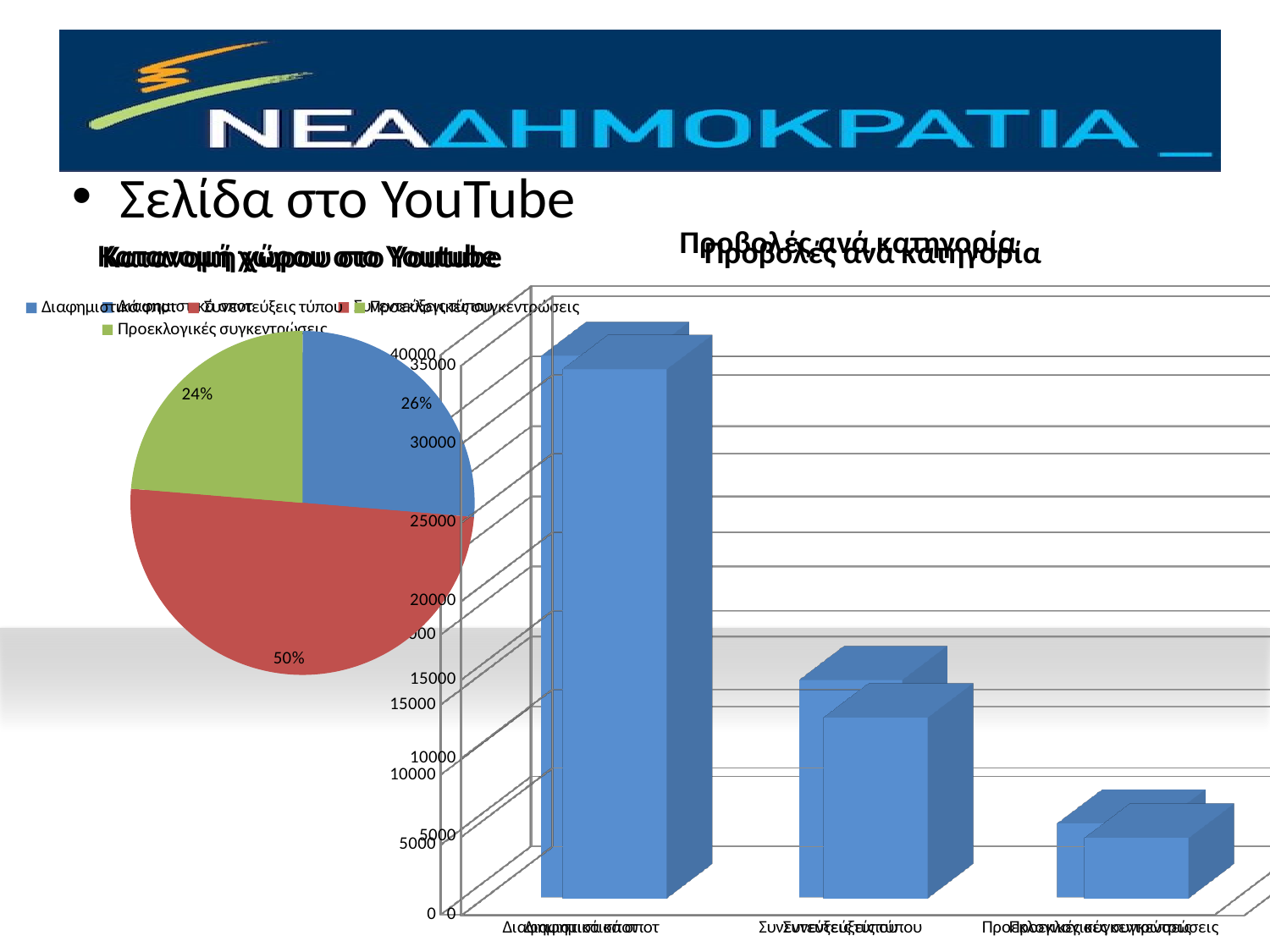
What kind of chart is the chart on the right titled 'Προβολές ανά κατηγορία'? Bar chart How many slices does the pie chart 'Κατανομή χώρου στο Youtube' have? 3 In the pie chart 'Κατανομή χώρου στο Youtube', which category has the smallest share? Προεκλογικές συγκεντρώσεις In the bar chart 'Προβολές ανά κατηγορία', do the values rise or fall from left to right across the categories? Fall In the bar chart 'Προβολές ανά κατηγορία', which category has the tallest bar? Διαφημιστικά σποτ In the bar chart 'Προβολές ανά κατηγορία', is the value for Διαφημιστικά σποτ greater or less than 30000? greater In the pie chart 'Κατανομή χώρου στο Youtube', which category has the largest share? Συνεντεύξεις τύπου In the pie chart 'Κατανομή χώρου στο Youtube', how many percentage points larger is the 50% slice than the 26% slice? 24 What kind of chart is the chart on the left titled 'Κατανομή χώρου στο Youtube'? Pie chart In the pie chart 'Κατανομή χώρου στο Youtube', what share does the red slice (Συνεντεύξεις τύπου) have? 50% In the pie chart 'Κατανομή χώρου στο Youtube', what share does the blue slice (Διαφημιστικά σποτ) have? 26% In the pie chart 'Κατανομή χώρου στο Youtube', what share does the green slice (Προεκλογικές συγκεντρώσεις) have? 24%